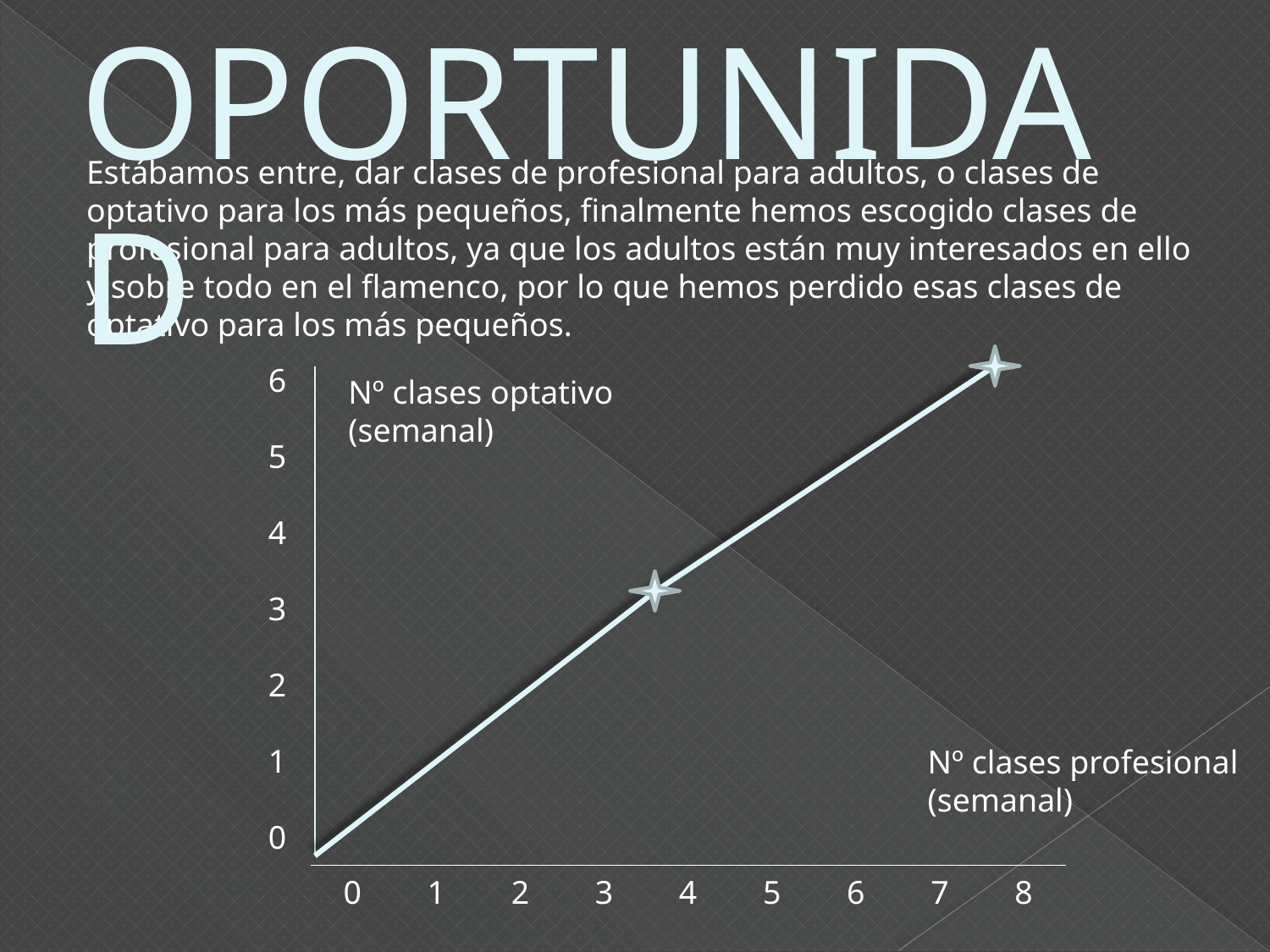
Is the vertical-axis value of the star marker at 4 professional classes greater or less than 4? less What is the label of the horizontal axis of the chart? Nº clases profesional (semanal) At what value on the horizontal axis does the line start? 0 Is the vertical-axis value of the star marker at 4 professional classes greater or less than 2? greater What is the label of the vertical axis of the chart? Nº clases optativo (semanal) Is the vertical-axis value of the star marker at 8 professional classes greater or less than 5? greater What kind of chart is shown on the slide? line chart How many star markers are drawn on the line in the chart? 2 How many tick values are labelled on the horizontal axis of the chart? 9 Does the line on the chart rise or fall as the number of professional classes per week increases? rises What is the highest value shown on the vertical axis of the chart? 6 What is the highest value shown on the horizontal axis of the chart? 8